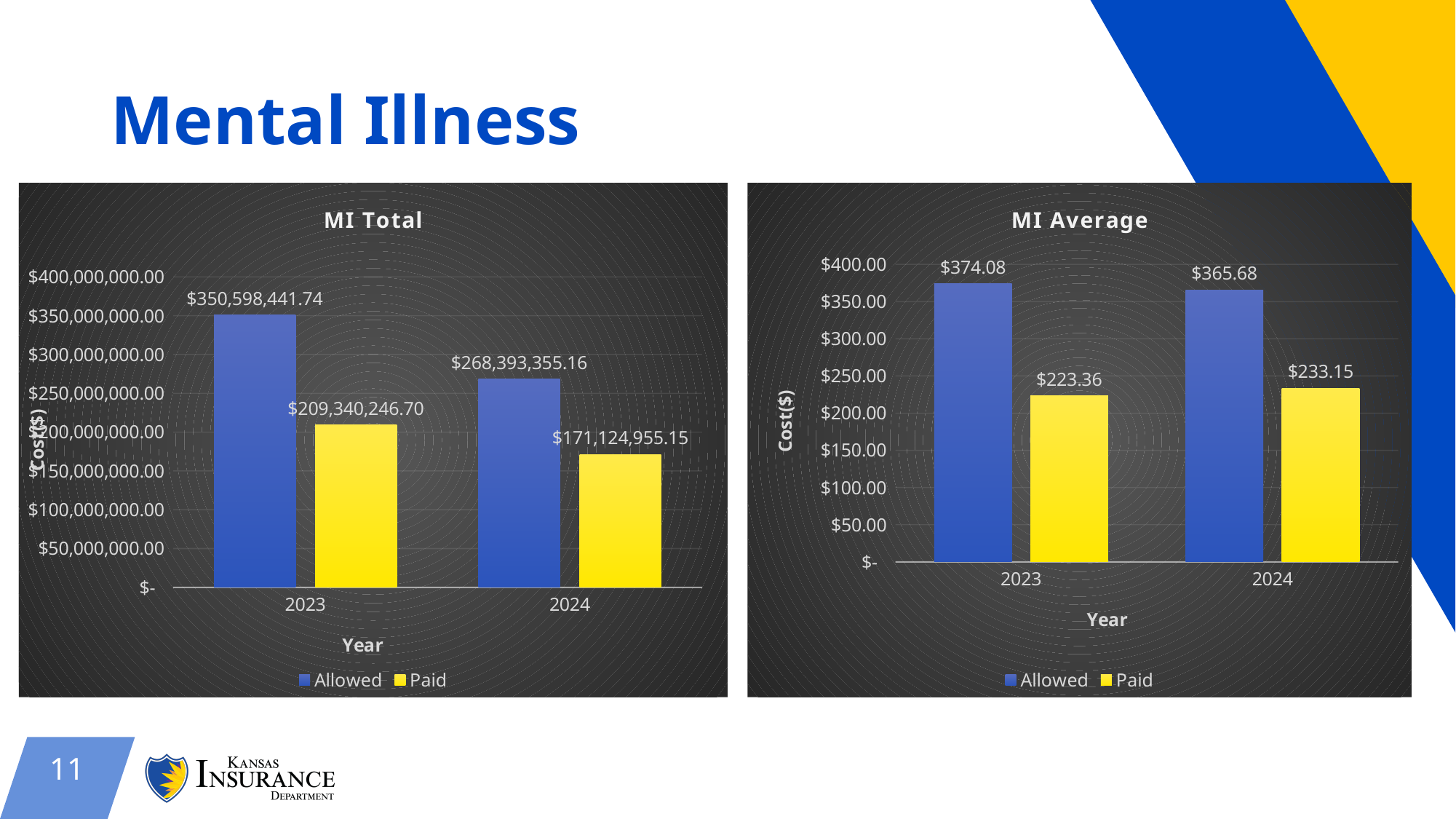
In the MI Total chart, what is the Paid value for 2024? $171,124,955.15 In the MI Total chart, what is the Allowed value for 2023? $350,598,441.74 What type of chart is the MI Average chart? Bar chart In the MI Average chart, what is the difference between the Allowed and Paid values for 2024? $132.53 In the MI Average chart, is the Paid value larger in 2023 or 2024? 2024 In the MI Average chart, what is the Paid value for 2023? $223.36 In the MI Total chart, does the Allowed value rise or fall from 2023 to 2024? Fall In the MI Total chart, what is the difference between the Allowed and Paid values for 2023? $141,258,195.04 In the MI Total chart, which bar has the lowest value? Paid in 2024 In the MI Average chart, what is the Allowed value for 2024? $365.68 How many series does the legend of the MI Total chart list? 2 In the MI Average chart, which bar has the highest value? Allowed in 2023